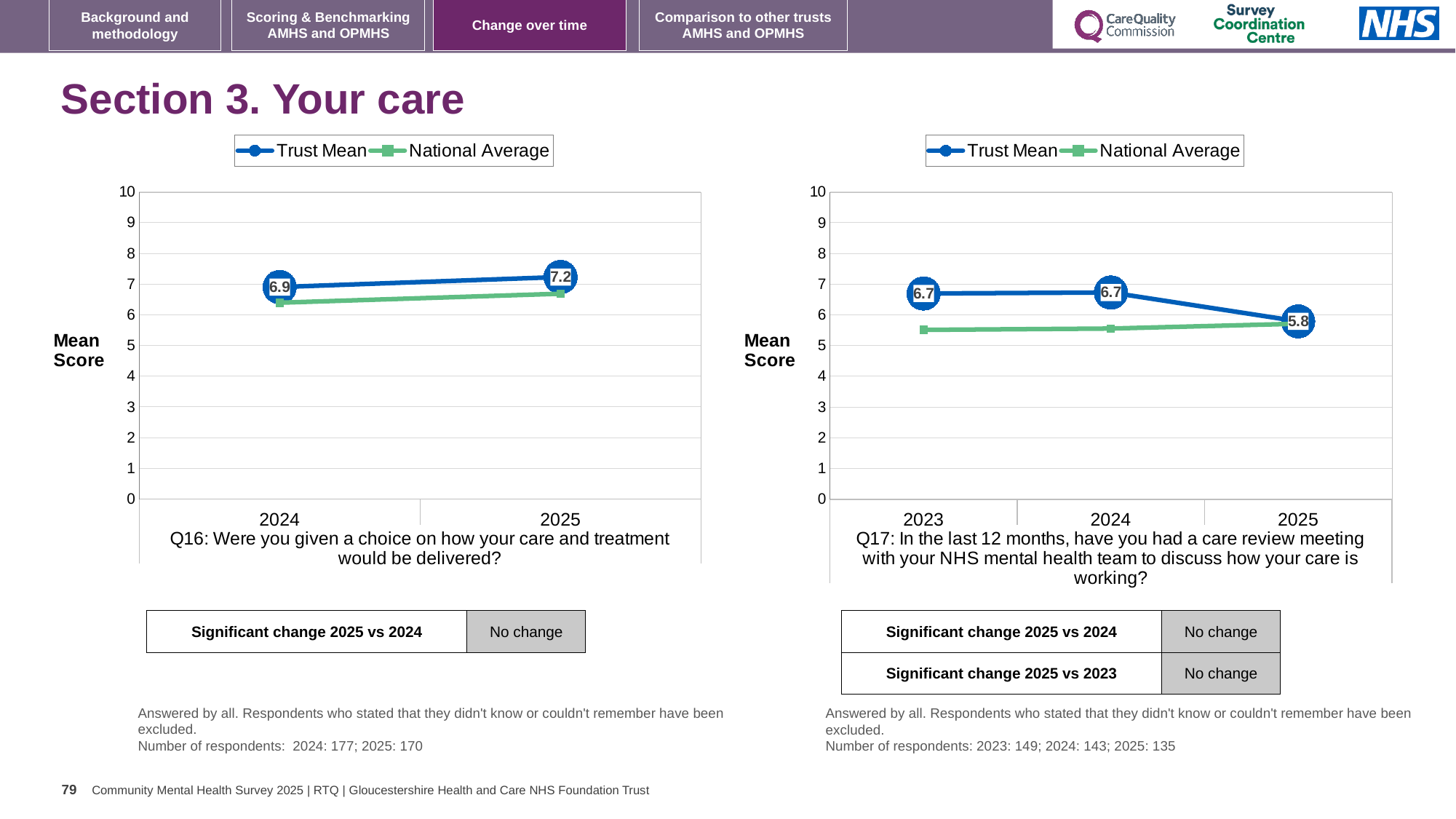
In the Q16 chart on the left, which is larger in 2024, the Trust Mean or the National Average? Trust Mean How many series does the legend of the Q17 chart on the right list? 2 In the Q17 chart on the right, what is the Trust Mean for 2025? 5.8 In the Q16 chart on the left, does the Trust Mean rise or fall from 2024 to 2025? rise In the Q16 chart on the left, by how much did the Trust Mean change from 2024 to 2025? 0.3 In the Q17 chart on the right, which year has the lowest Trust Mean? 2025 In the Q17 chart on the right, what is the difference between the Trust Mean in 2024 and in 2025? 0.9 In the Q16 chart on the left, what is the Trust Mean for 2024? 6.9 In the Q16 chart on the left, is the National Average for 2024 greater or less than 7? less In the Q17 chart on the right, how many years are plotted on the x axis? 3 In the Q17 chart on the right, what is the Trust Mean for 2023? 6.7 In the Q16 chart on the left, what is the Trust Mean for 2025? 7.2